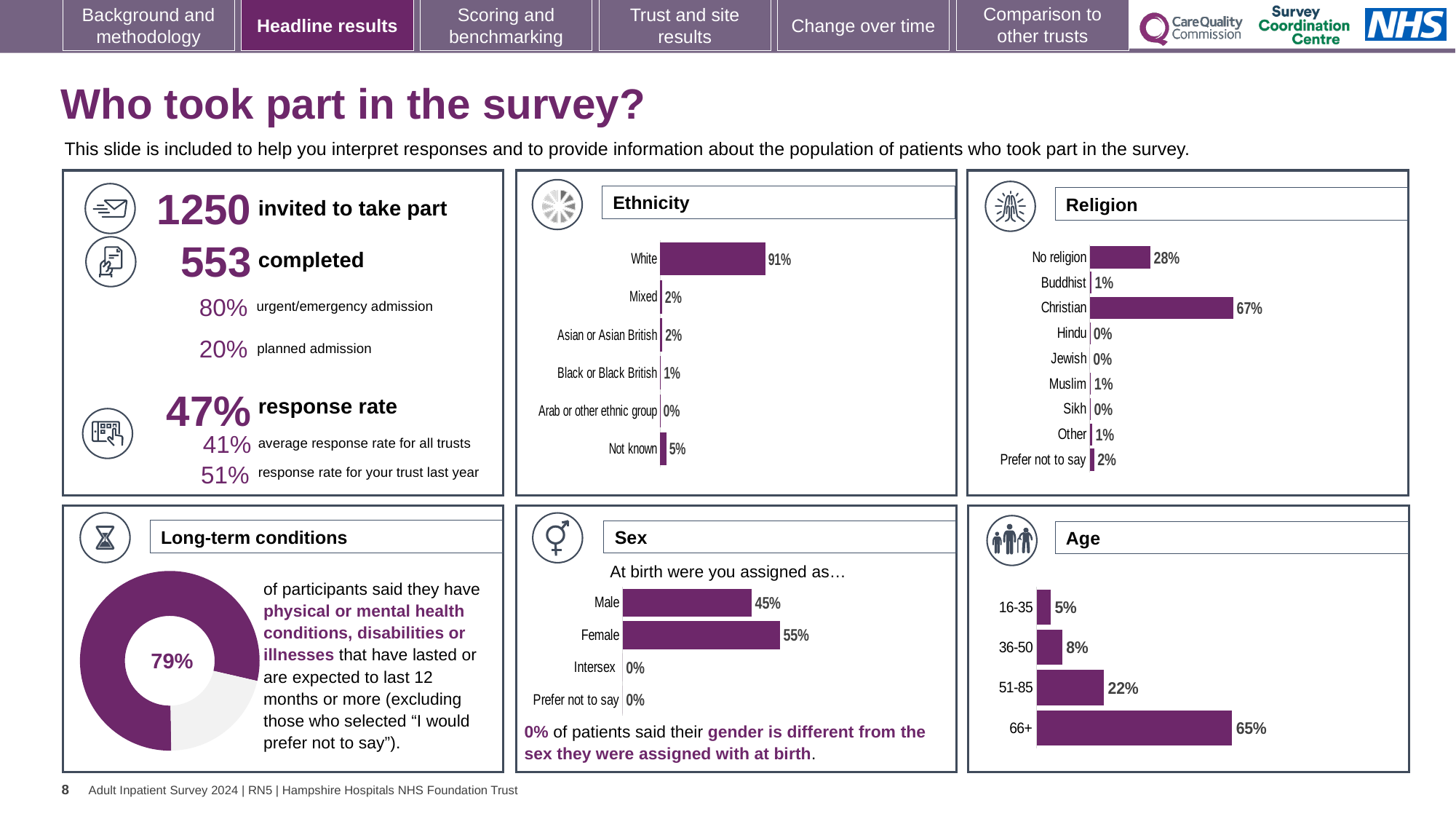
In the Ethnicity chart, what percentage of respondents are White? 91% In the Long-term conditions chart, what share of participants said they have physical or mental health conditions, disabilities or illnesses? 79% In the Ethnicity chart, what percentage is shown for Not known? 5% In the Religion chart, which category has the highest value? Christian In the Religion chart, what percentage of respondents have No religion? 28% In the Age chart, which age group has the lowest value? 16-35 In the Age chart, do the values rise or fall as the age groups get older? rise In the Sex chart, what is the difference between Female and Male? 10 percentage points How many categories does the Religion chart show? 9 In the Religion chart, what is the difference between Christian and No religion? 39 percentage points In the Age chart, what percentage of respondents are aged 51-85? 22% In the Sex chart, which is larger, Male or Female? Female